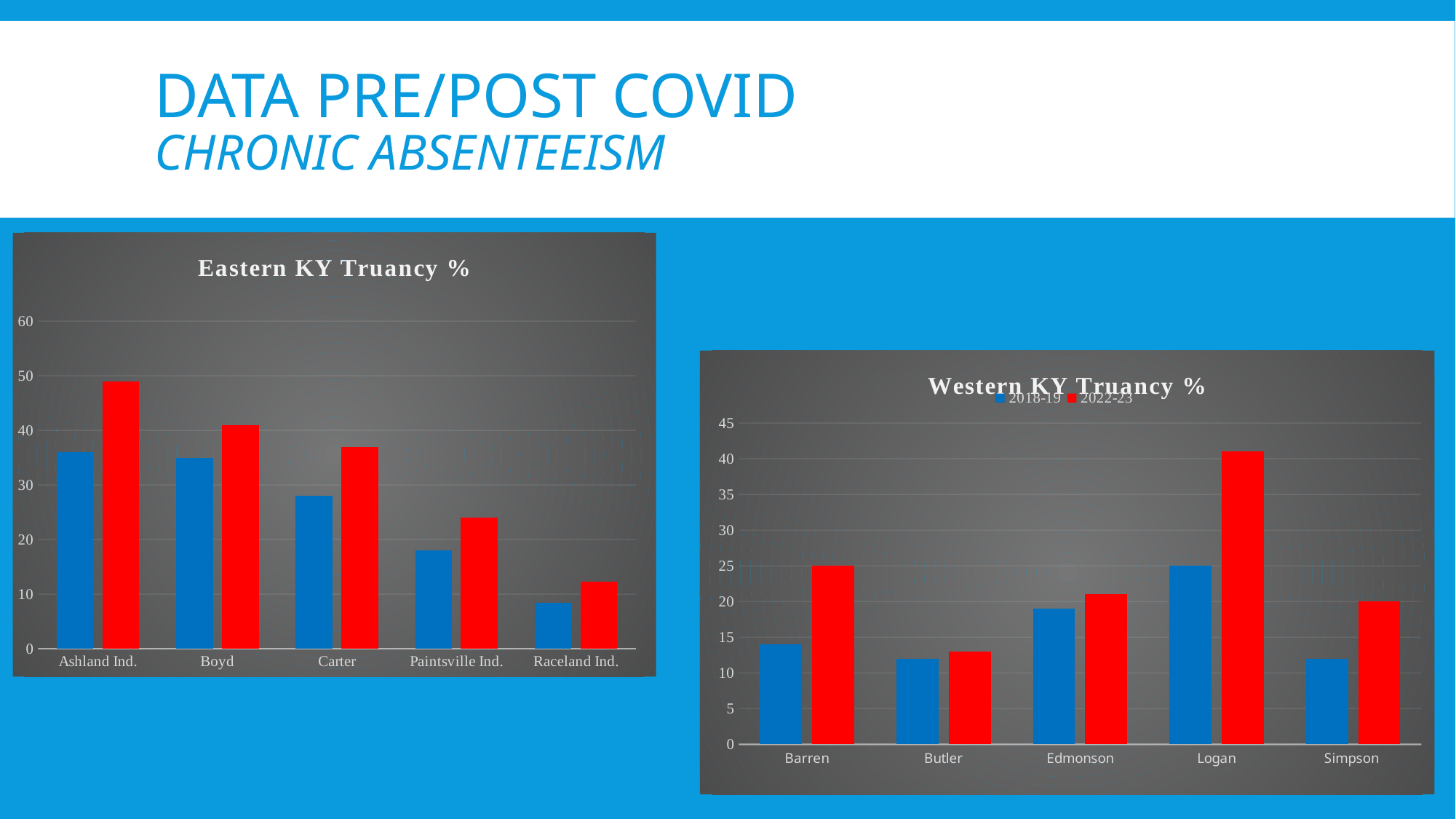
In the Eastern KY Truancy % chart, which district has the tallest red bar? Ashland Ind. In the Eastern KY Truancy % chart, which district has the shortest blue bar? Raceland Ind. What kind of chart is the Eastern KY Truancy % chart? bar chart What are the two legend entries on the Western KY Truancy % chart? 2018-19 and 2022-23 How many districts are shown on the x axis of the Eastern KY Truancy % chart? 5 In the Eastern KY Truancy % chart, is the blue bar for Raceland Ind. greater or less than 10? less In the Western KY Truancy % chart, which county has the lowest 2022-23 value? Butler In the Eastern KY Truancy % chart, is the red bar for Ashland Ind. greater or less than 40? greater How many series does the legend of the Western KY Truancy % chart list? 2 In the Western KY Truancy % chart, is the 2022-23 value for Logan greater or less than 35? greater In the Western KY Truancy % chart, which county has the highest 2022-23 value? Logan In the Western KY Truancy % chart, which is larger: the 2022-23 value for Barren or the 2022-23 value for Edmonson? Barren